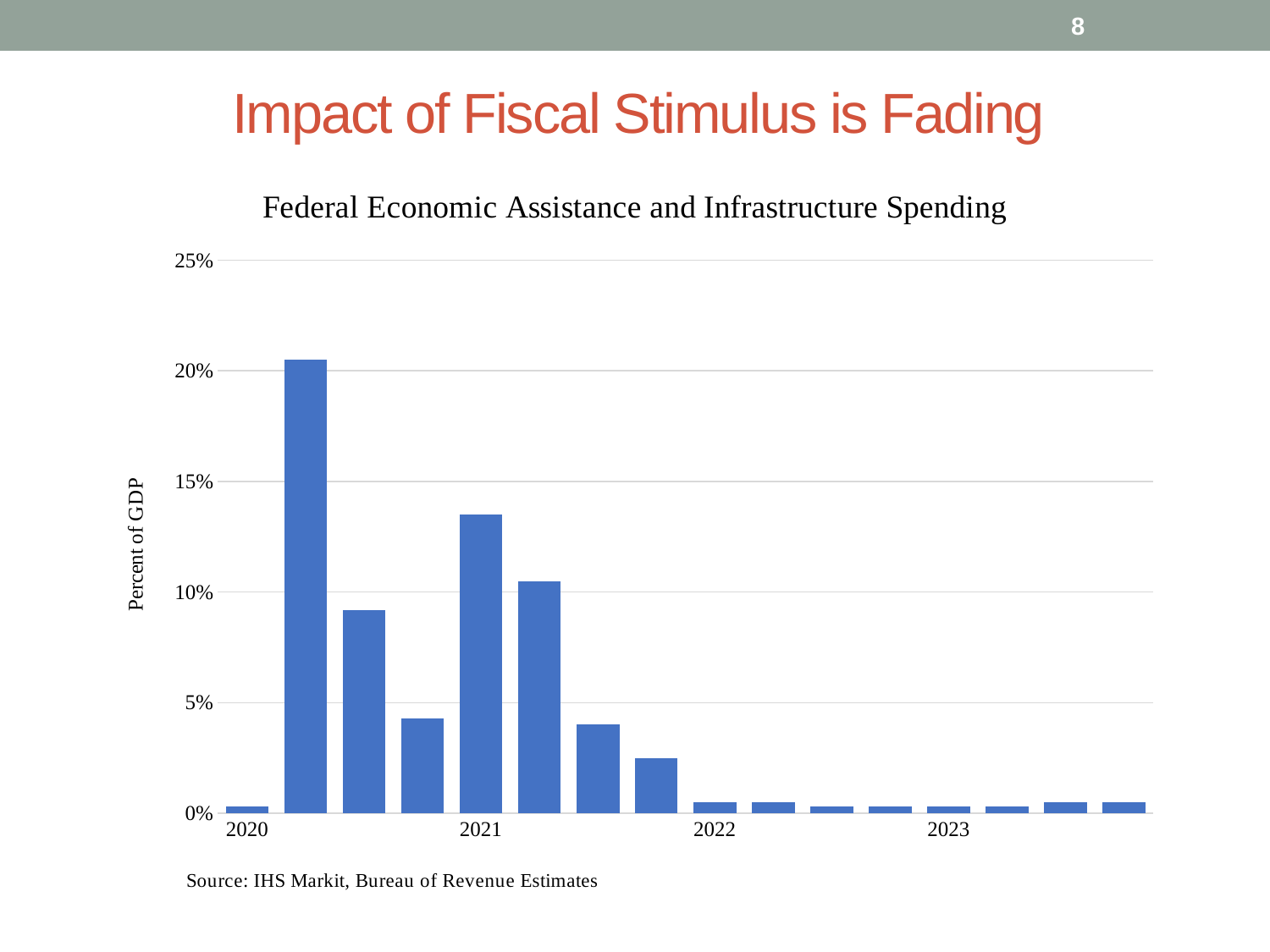
Is the value of the bar directly above the 2021 label greater or less than 10%? greater Is the value of the tallest bar greater or less than 15%? greater Do the bar values generally rise or fall from 2021 to 2023? fall What kind of chart is shown on the slide? bar chart Is the value of the bar directly above the 2023 label greater or less than 5%? less How many bars are plotted in the chart? 16 Which year on the x axis contains the tallest bar? 2020 Which is larger, the bar directly above the 2021 label or the bar directly above the 2022 label? the bar above 2021 What is the title of the chart? Federal Economic Assistance and Infrastructure Spending What is the label on the vertical axis of the chart? Percent of GDP What is the highest value shown on the vertical axis? 25%